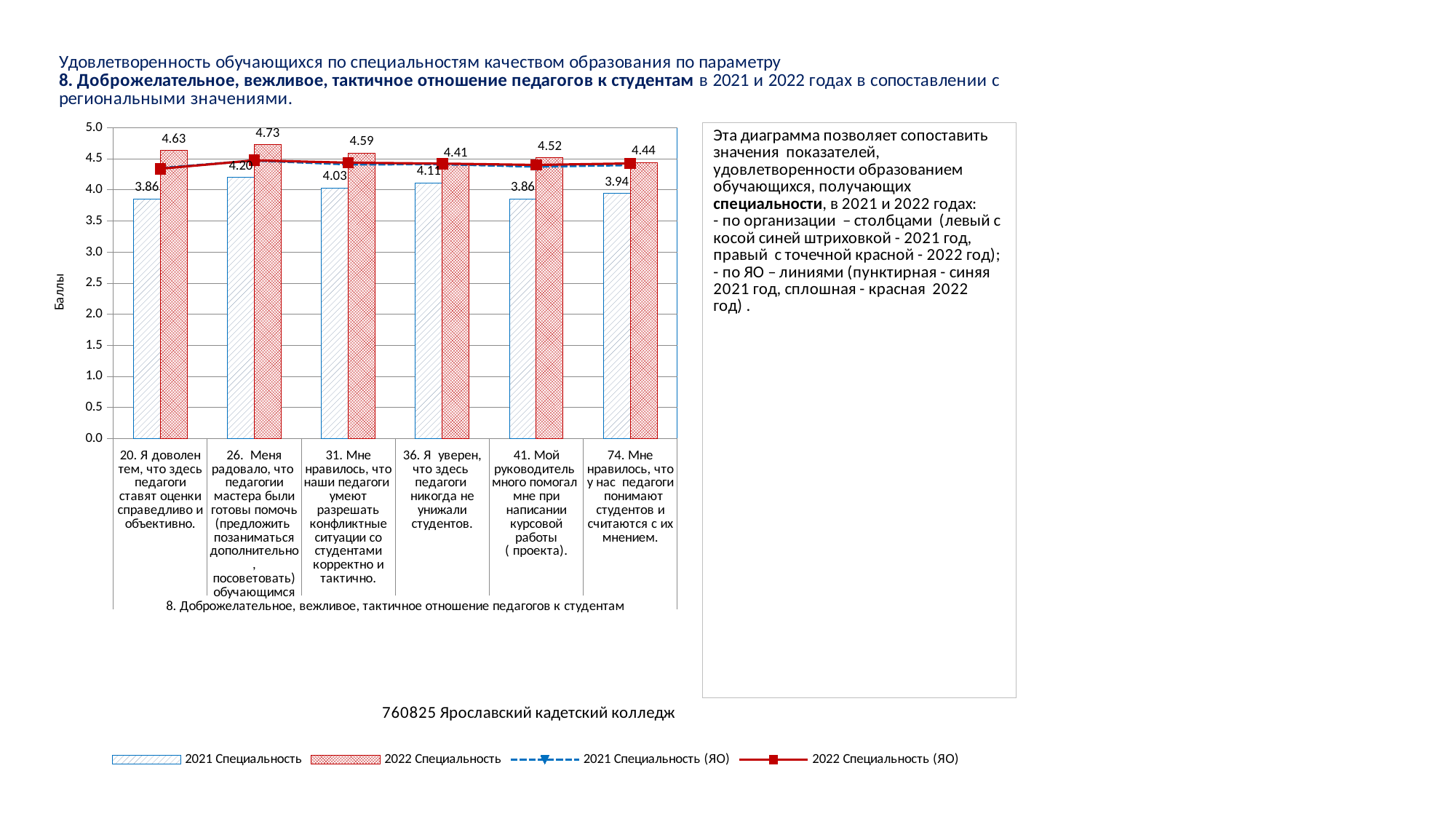
How many series does the chart legend list? 4 What is the 2022 Специальность value for question 26 (Меня радовало, что педагоги и мастера были готовы помочь)? 4.73 What is the 2021 Специальность value for question 31 (Мне нравилось, что наши педагоги умеют разрешать конфликтные ситуации)? 4.03 Which question has the highest 2022 Специальность value? 26. Меня радовало, что педагоги и мастера были готовы помочь What is the difference between the 2022 and 2021 Специальность values for question 20 (Я доволен тем, что здесь педагоги ставят оценки справедливо и объективно)? 0.77 Which is larger for question 41: the 2021 Специальность value or the 2022 Специальность value? 2022 Специальность What is the label of the y axis of the chart? Баллы Which question has the lowest 2022 Специальность value? 36. Я уверен, что здесь педагоги никогда не унижали студентов. How many survey questions (categories) are shown on the x axis of the chart? 6 What kind of chart is shown on the slide? Combined bar and line chart Is the 2021 Специальность value for question 36 greater or less than 4.0? greater What is the 2021 Специальность value for question 74 (Мне нравилось, что у нас педагоги понимают студентов)? 3.94